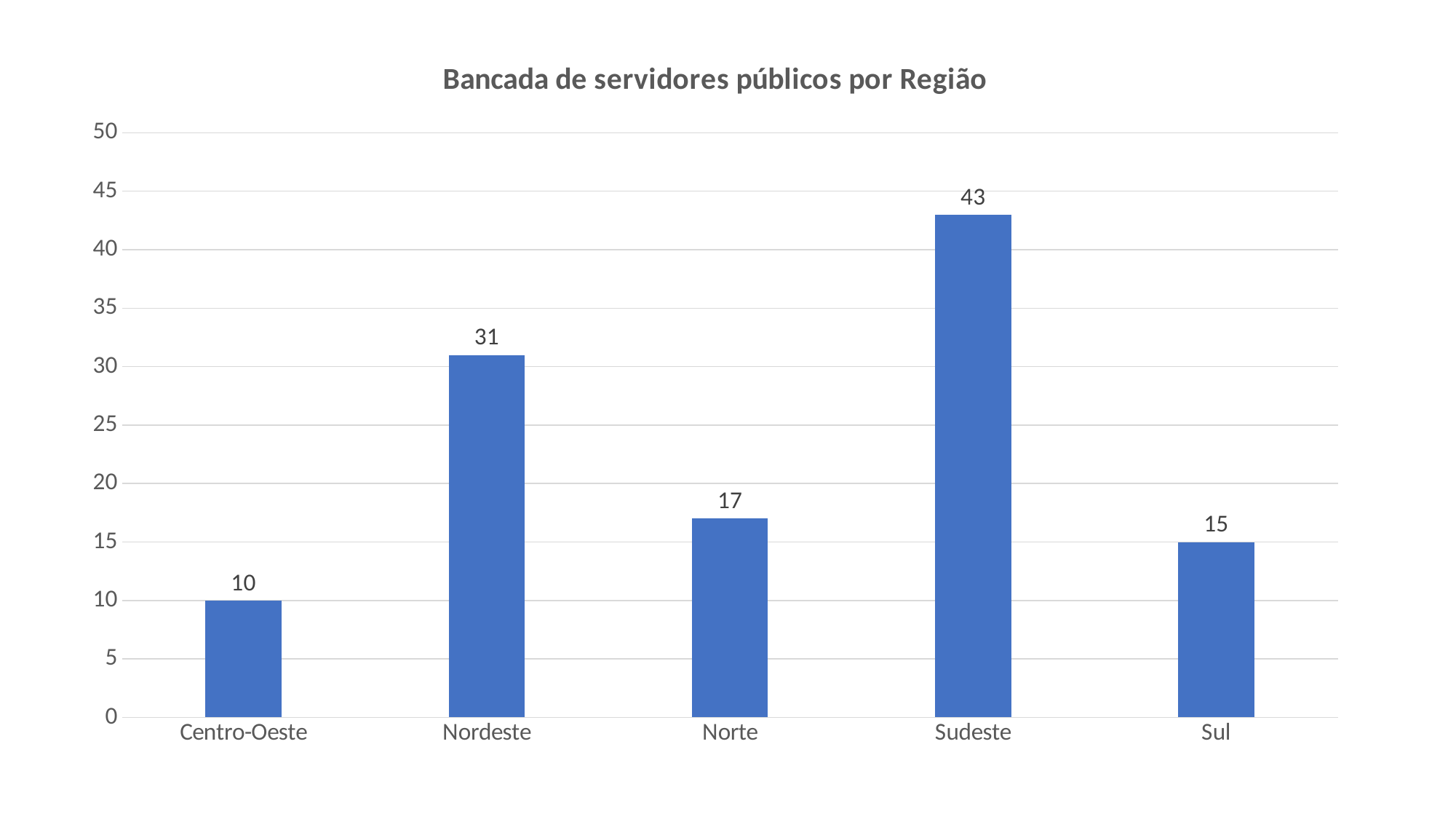
What is the title of the chart? Bancada de servidores públicos por Região What kind of chart is this? Bar chart What is the difference between the values for Sudeste and Nordeste? 12 What is the value for Sudeste? 43 Which region has the lowest value? Centro-Oeste What is the value for Centro-Oeste? 10 What is the value for Nordeste? 31 Is the value for Nordeste greater or less than 30? greater How many regions are shown on the chart? 5 What is the difference between the values for Norte and Sul? 2 Which region has the highest value? Sudeste Which is larger, the value for Norte or the value for Sul? Norte